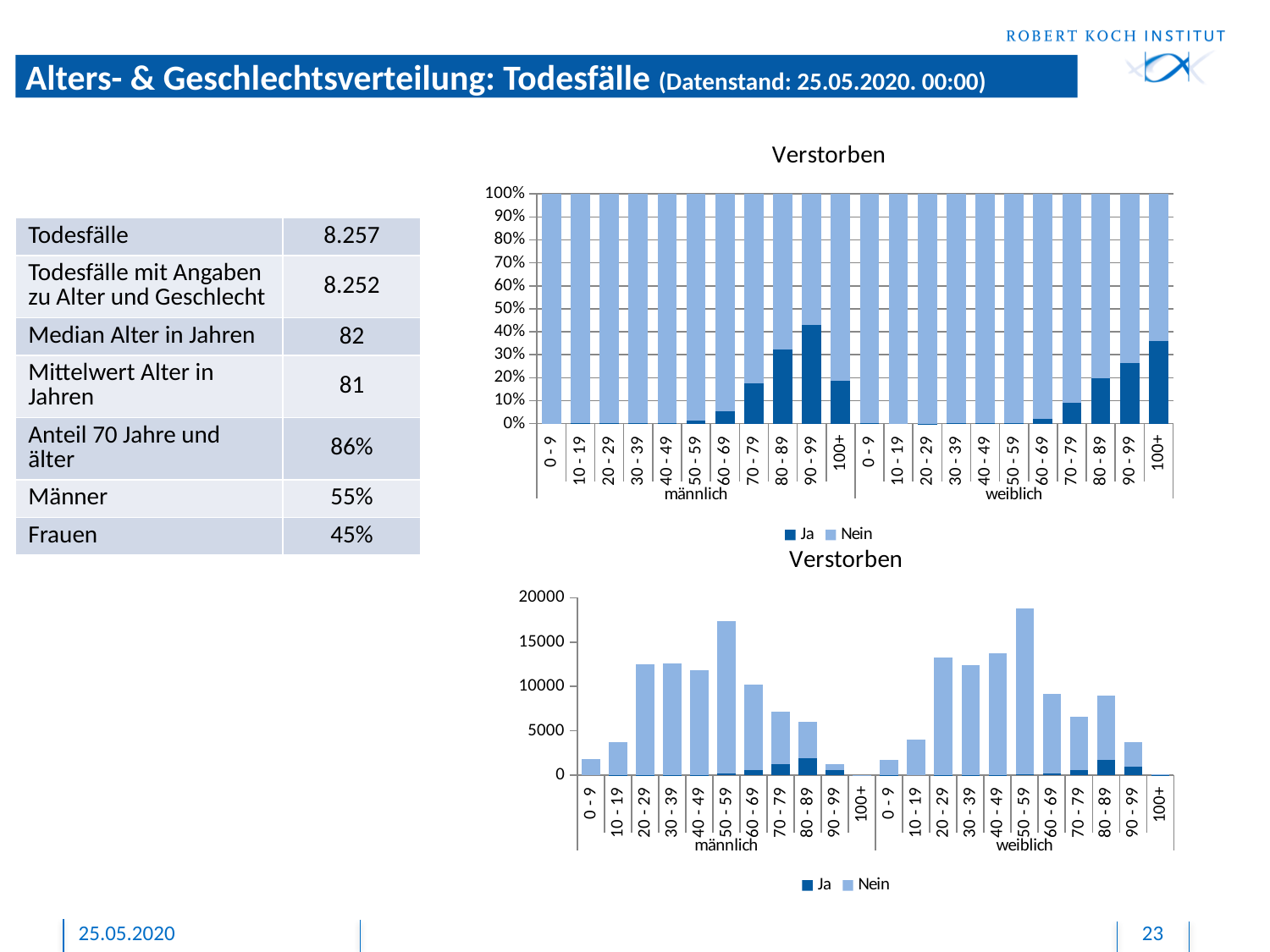
What are the legend entries of the bottom 'Verstorben' chart? Ja, Nein How many series does the legend of the top 'Verstorben' chart list? 2 In the top 'Verstorben' chart, which has the larger 'Ja' share: männlich 90 - 99 or weiblich 90 - 99? männlich 90 - 99 In the bottom 'Verstorben' chart, which bar is taller: männlich 40 - 49 or weiblich 40 - 49? weiblich 40 - 49 What kind of chart is the top chart titled 'Verstorben'? bar chart In the bottom 'Verstorben' chart, is the total for weiblich 50 - 59 greater or less than 15000? greater In the top 'Verstorben' chart, which age group among männlich has the highest 'Ja' share? 90 - 99 In the top 'Verstorben' chart, is the 'Ja' share for weiblich 90 - 99 greater or less than 20%? greater In the bottom 'Verstorben' chart, is the total for männlich 100+ greater or less than 5000? less In the bottom 'Verstorben' chart, which bar is the tallest overall? weiblich 50 - 59 How many age-group bars are shown in the bottom 'Verstorben' chart in total? 22